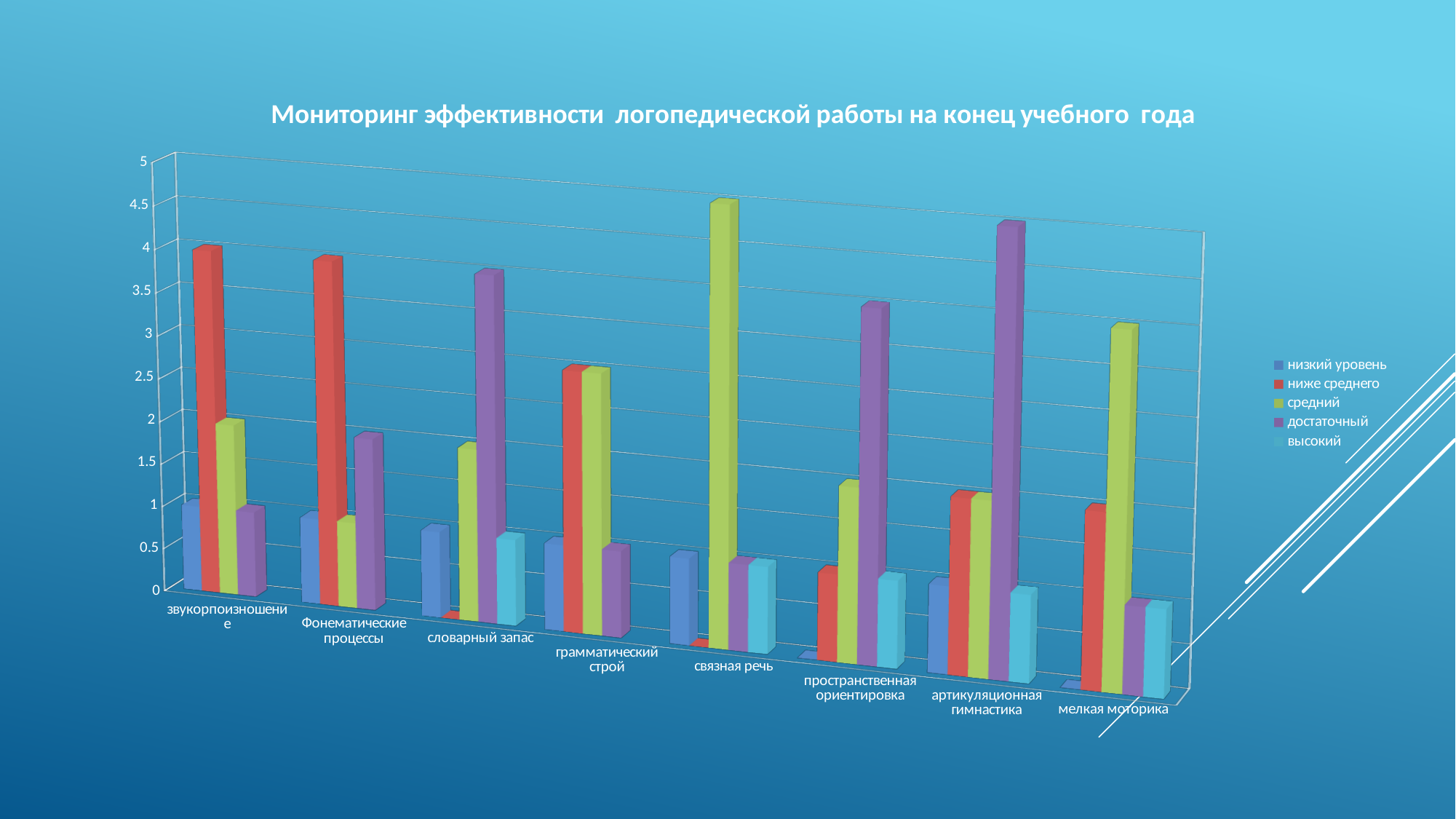
Is the value of 'средний' for 'связная речь' greater or less than 4? greater Which series has the highest value for the category 'звукорпоизношение'? ниже среднего Is the value of 'ниже среднего' for 'звукорпоизношение' greater or less than 3? greater Is the value of 'низкий уровень' for 'звукорпоизношение' greater or less than 2? less How many categories are shown on the x axis? 8 Which series has the highest value for the category 'артикуляционная гимнастика'? достаточный What kind of chart is shown on the slide? bar chart What is the title of the chart? Мониторинг эффективности логопедической работы на конец учебного года Which series has the highest value for the category 'связная речь'? средний Which is larger: the value of 'средний' for 'связная речь' or the value of 'достаточный' for 'пространственная ориентировка'? средний for связная речь How many series does the legend list? 5 Which is larger for 'звукорпоизношение': the value of 'ниже среднего' or the value of 'средний'? ниже среднего